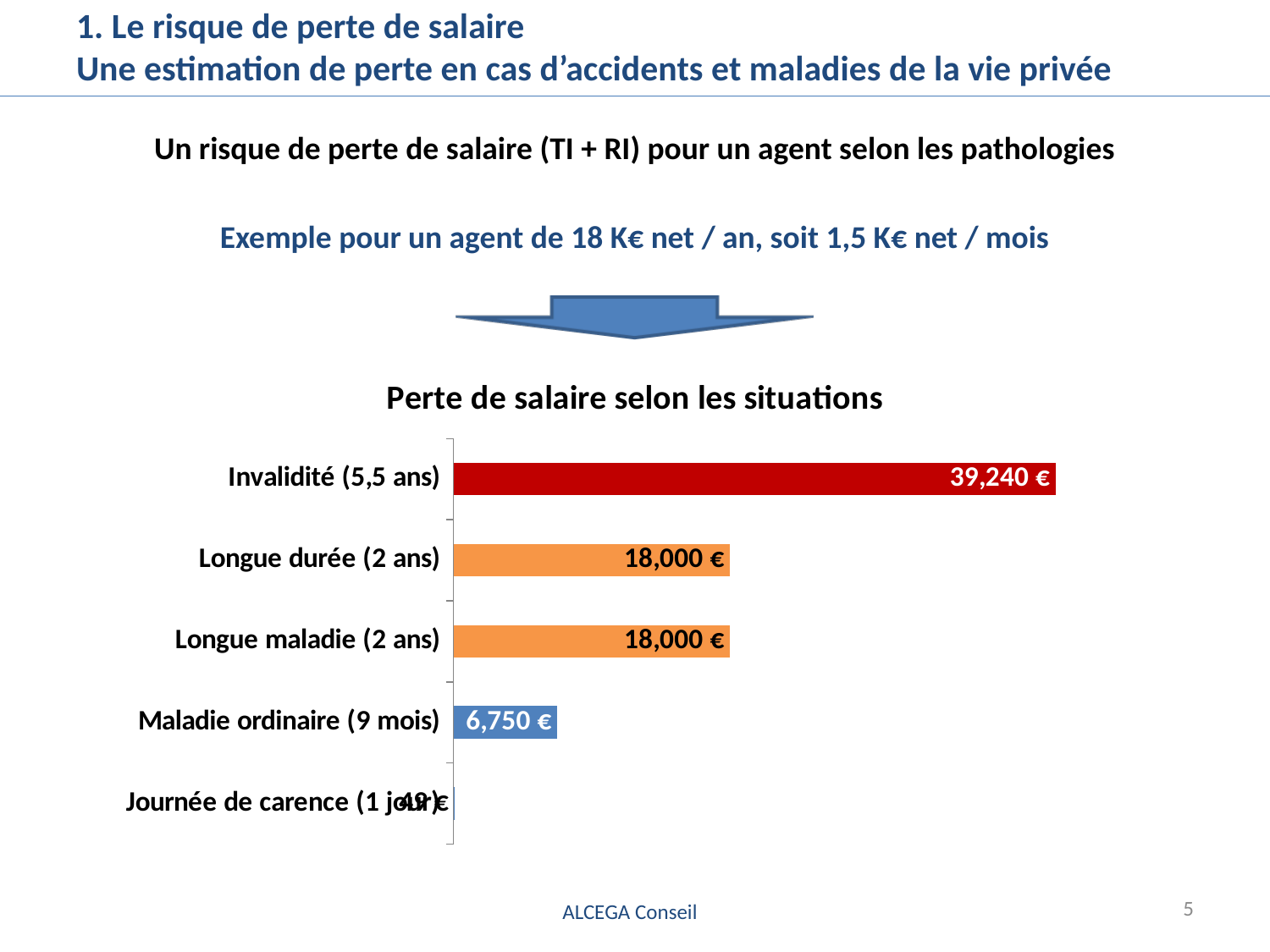
Which is larger, the value for Invalidité (5,5 ans) or the value for Maladie ordinaire (9 mois)? Invalidité (5,5 ans) What is the difference between the values for Longue maladie (2 ans) and Maladie ordinaire (9 mois)? 11,250 € What is the value for Longue durée (2 ans)? 18,000 € How many categories are shown in the chart? 5 What is the value for Invalidité (5,5 ans)? 39,240 € Which category has the lowest value? Journée de carence (1 jour) Which category has the highest value? Invalidité (5,5 ans) What is the value for Maladie ordinaire (9 mois)? 6,750 € What type of chart is shown on the slide? Bar chart What is the title of the chart? Perte de salaire selon les situations What is the difference between the values for Invalidité (5,5 ans) and Longue durée (2 ans)? 21,240 € What is the value for Longue maladie (2 ans)? 18,000 €